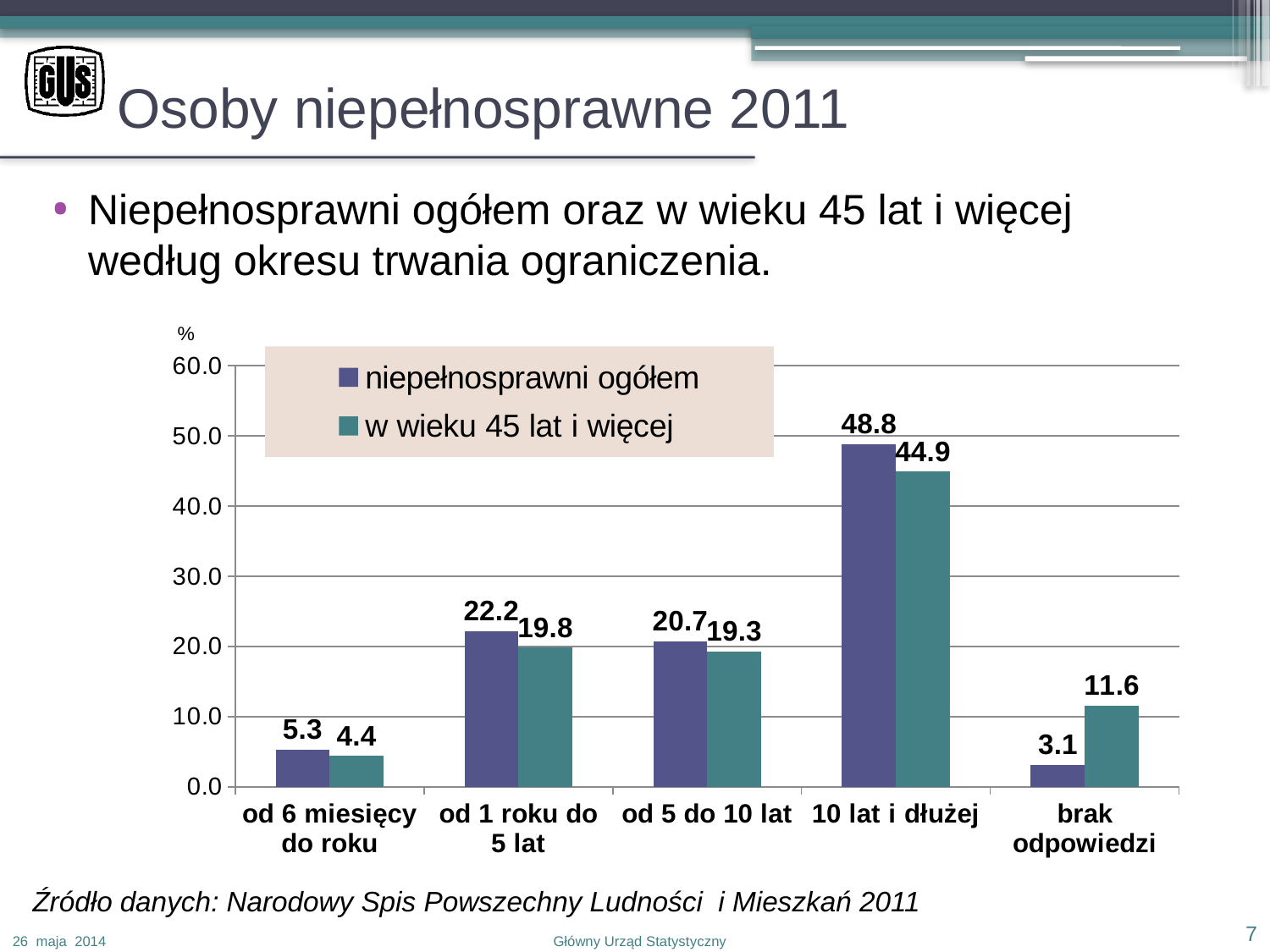
What kind of chart is shown on the slide? bar chart How many categories are shown on the x axis? 5 What unit is shown on the y axis of the chart? % Which category has the lowest value for 'niepełnosprawni ogółem'? brak odpowiedzi Is the value for 'niepełnosprawni ogółem' in the 'od 5 do 10 lat' category greater or less than 20.0? greater What is the value for 'w wieku 45 lat i więcej' in the 'brak odpowiedzi' category? 11.6 What is the difference between 'niepełnosprawni ogółem' and 'w wieku 45 lat i więcej' in the '10 lat i dłużej' category? 3.9 How many series does the legend list? 2 In the 'brak odpowiedzi' category, which series has the larger value? w wieku 45 lat i więcej What is the value for 'niepełnosprawni ogółem' in the 'od 1 roku do 5 lat' category? 22.2 What is the value for 'niepełnosprawni ogółem' in the '10 lat i dłużej' category? 48.8 Which category has the highest value for 'w wieku 45 lat i więcej'? 10 lat i dłużej